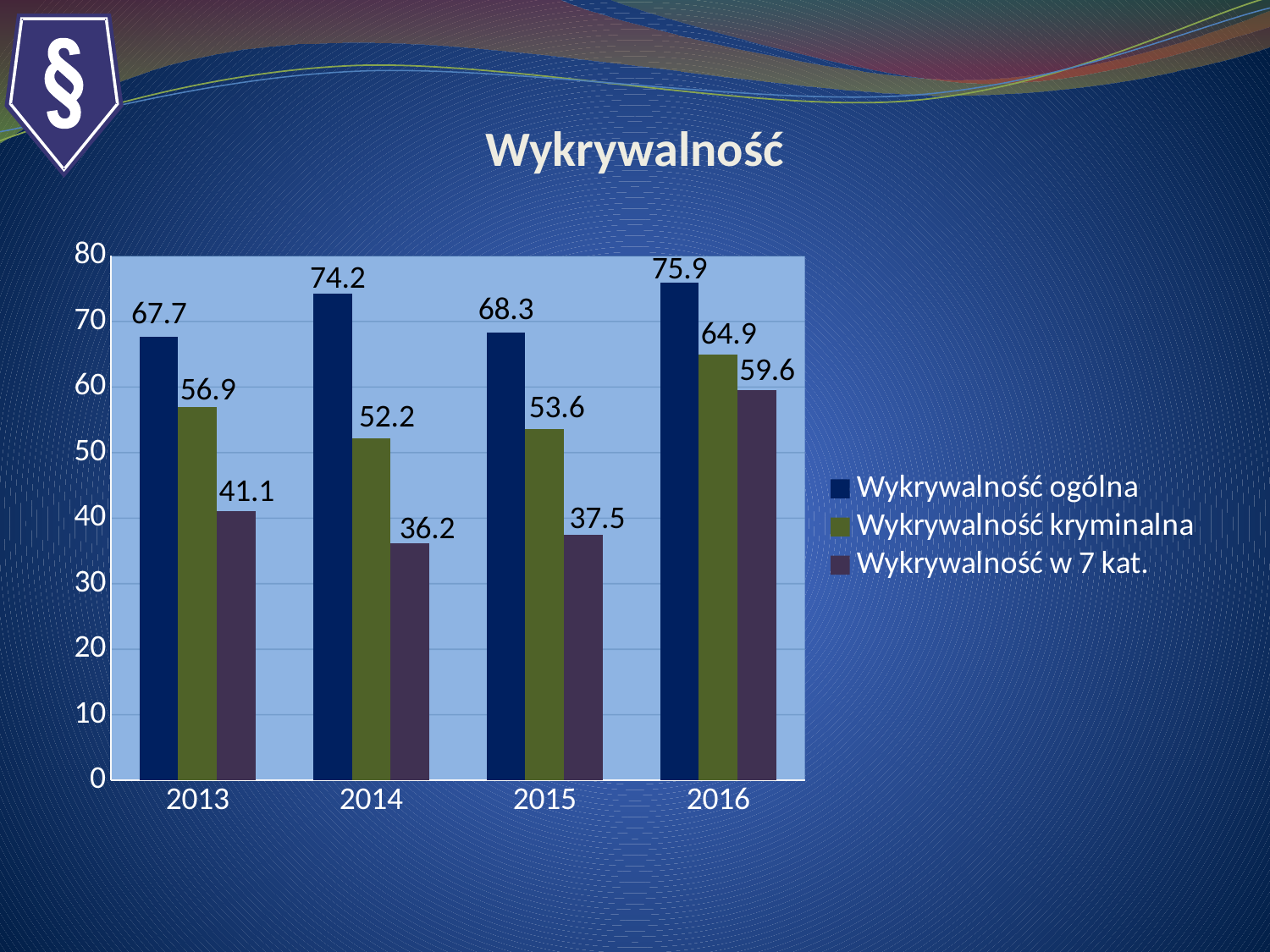
How many series does the legend list? 3 How many years are shown on the x axis? 4 What is the value of Wykrywalność ogólna for 2014? 74.2 Which is larger: Wykrywalność kryminalna in 2013 or in 2014? 2013 What is the title of the chart? Wykrywalność What is the value of Wykrywalność w 7 kat. for 2013? 41.1 What is the value of Wykrywalność kryminalna for 2016? 64.9 Is the value of Wykrywalność w 7 kat. for 2016 greater or less than 50? greater What kind of chart is shown on the slide? bar chart In which year is Wykrywalność w 7 kat. lowest? 2014 In which year is Wykrywalność ogólna highest? 2016 What is the difference between Wykrywalność ogólna and Wykrywalność kryminalna in 2015? 14.7